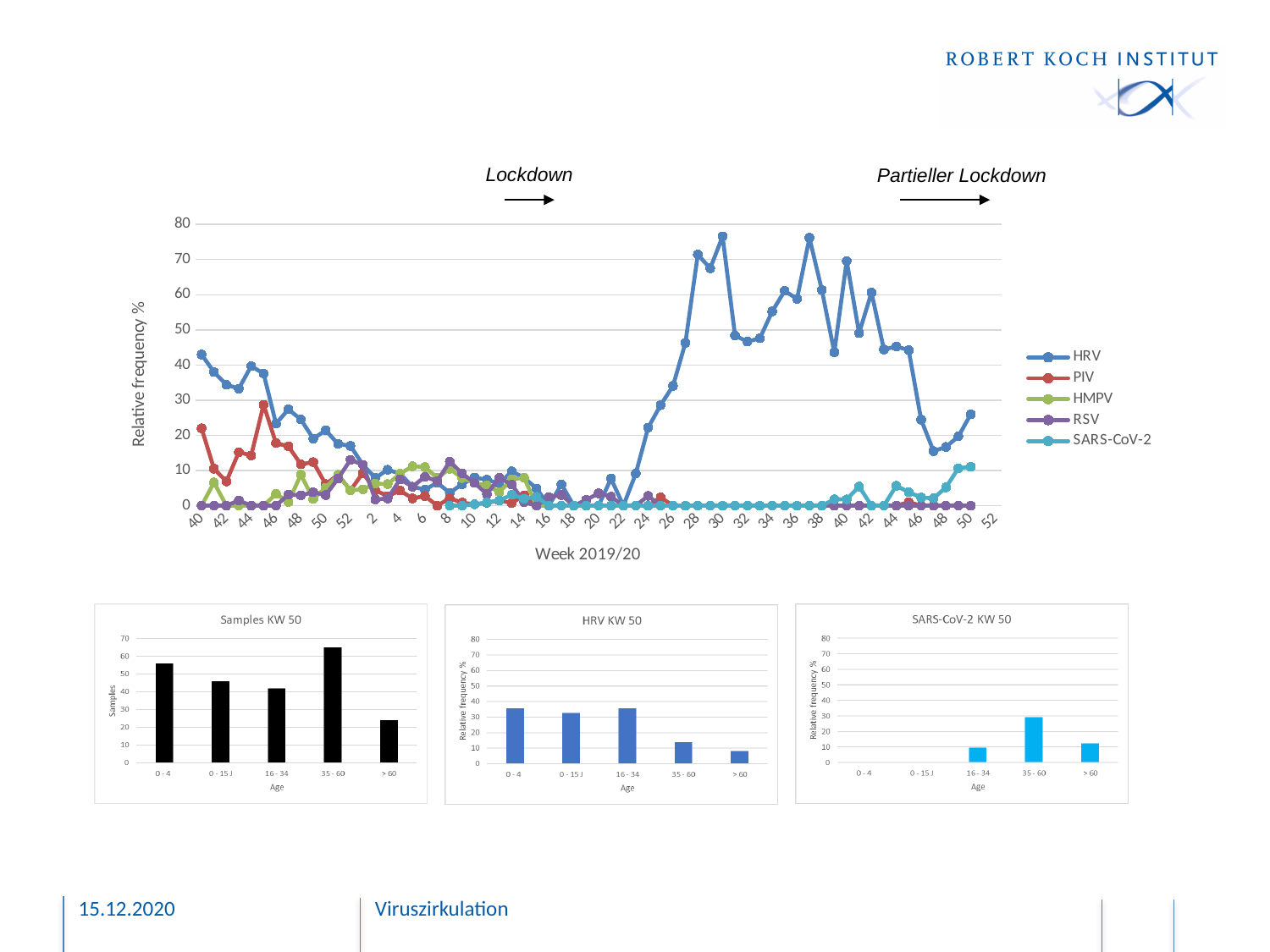
In the 'HRV KW 50' chart, which is larger, the value for 0 - 4 or the value for 35 - 60? 0 - 4 What is the x-axis title of the top line chart? Week 2019/20 In the 'HRV KW 50' chart, which age group has the lowest relative frequency? > 60 In the 'SARS-CoV-2 KW 50' chart, which age group has the highest relative frequency? 35 - 60 In the 'Samples KW 50' chart, is the value for the 35 - 60 age group greater or less than 60? greater In the top line chart, which series reaches the highest relative frequency over the whole period? HRV How many series does the legend of the top line chart list? 5 In the top line chart, is the HRV value at week 30 greater or less than 70? greater In the 'Samples KW 50' chart, which age group has the highest number of samples? 35 - 60 In the 'Samples KW 50' chart, which age group has the lowest number of samples? > 60 What kind of chart is the large chart at the top of the slide showing relative frequency by week? line chart In the top line chart, is the SARS-CoV-2 value at week 50 greater or less than 20? less